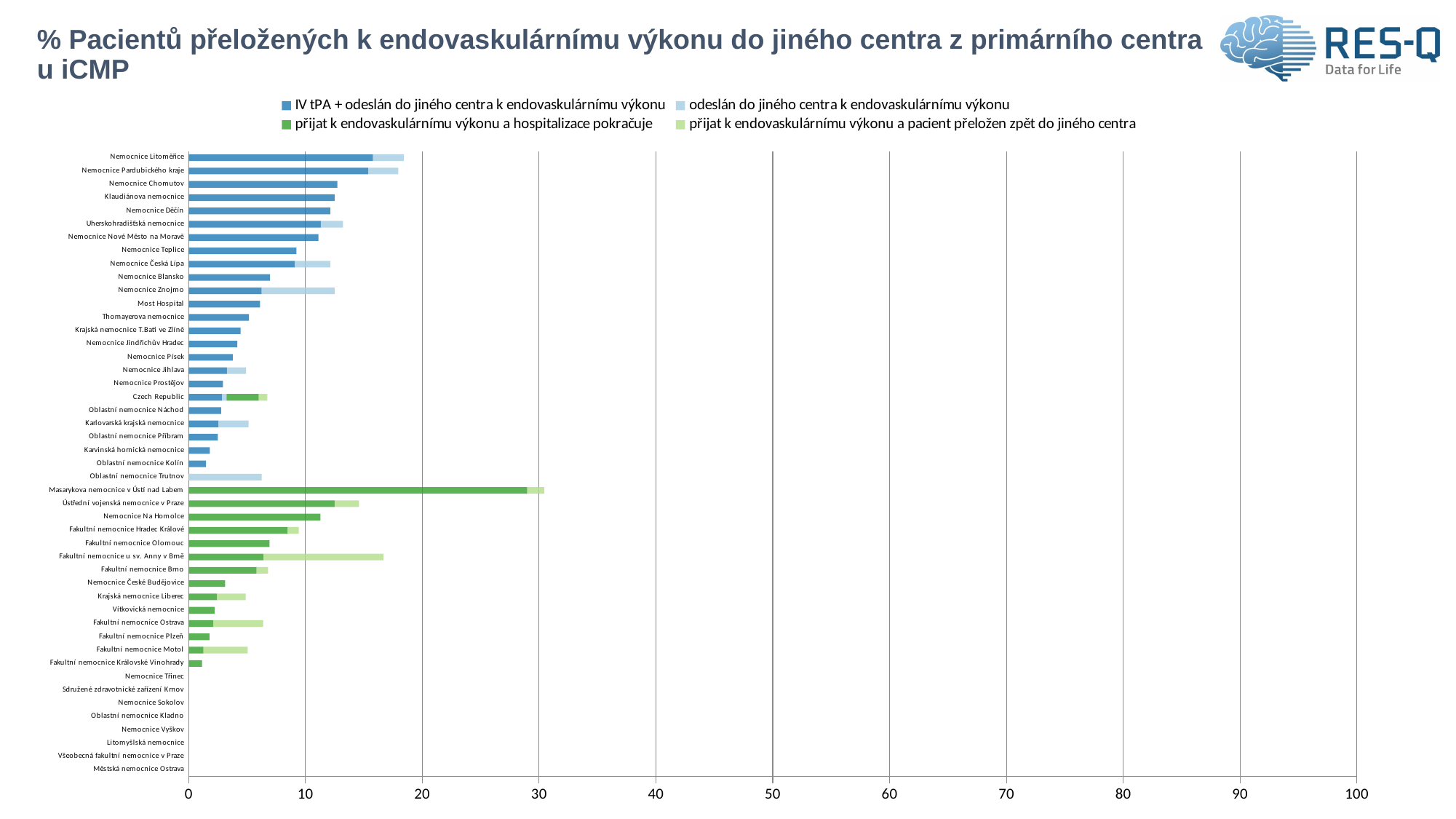
Is the value of the 'IV tPA + odeslán do jiného centra k endovaskulárnímu výkonu' bar for Nemocnice Litoměřice greater or less than 10? greater Which is larger for Fakultní nemocnice u sv. Anny v Brně: the 'přijat k endovaskulárnímu výkonu a hospitalizace pokračuje' bar or the 'přijat k endovaskulárnímu výkonu a pacient přeložen zpět do jiného centra' bar? přijat k endovaskulárnímu výkonu a pacient přeložen zpět do jiného centra What kind of chart is shown on the slide? bar chart What is the maximum value shown on the horizontal axis? 100 What is the title of the chart? % Pacientů přeložených k endovaskulárnímu výkonu do jiného centra z primárního centra u iCMP Which has the longer bar: Masarykova nemocnice v Ústí nad Labem or Nemocnice Litoměřice? Masarykova nemocnice v Ústí nad Labem How many series does the legend list? 4 Is the value of the 'přijat k endovaskulárnímu výkonu a hospitalizace pokračuje' bar for Masarykova nemocnice v Ústí nad Labem greater or less than 20? greater Is the value of the 'IV tPA + odeslán do jiného centra k endovaskulárnímu výkonu' bar for Oblastní nemocnice Kolín greater or less than 10? less How many hospitals/categories are listed on the vertical axis? 47 Which category has the longest bar in the chart? Masarykova nemocnice v Ústí nad Labem